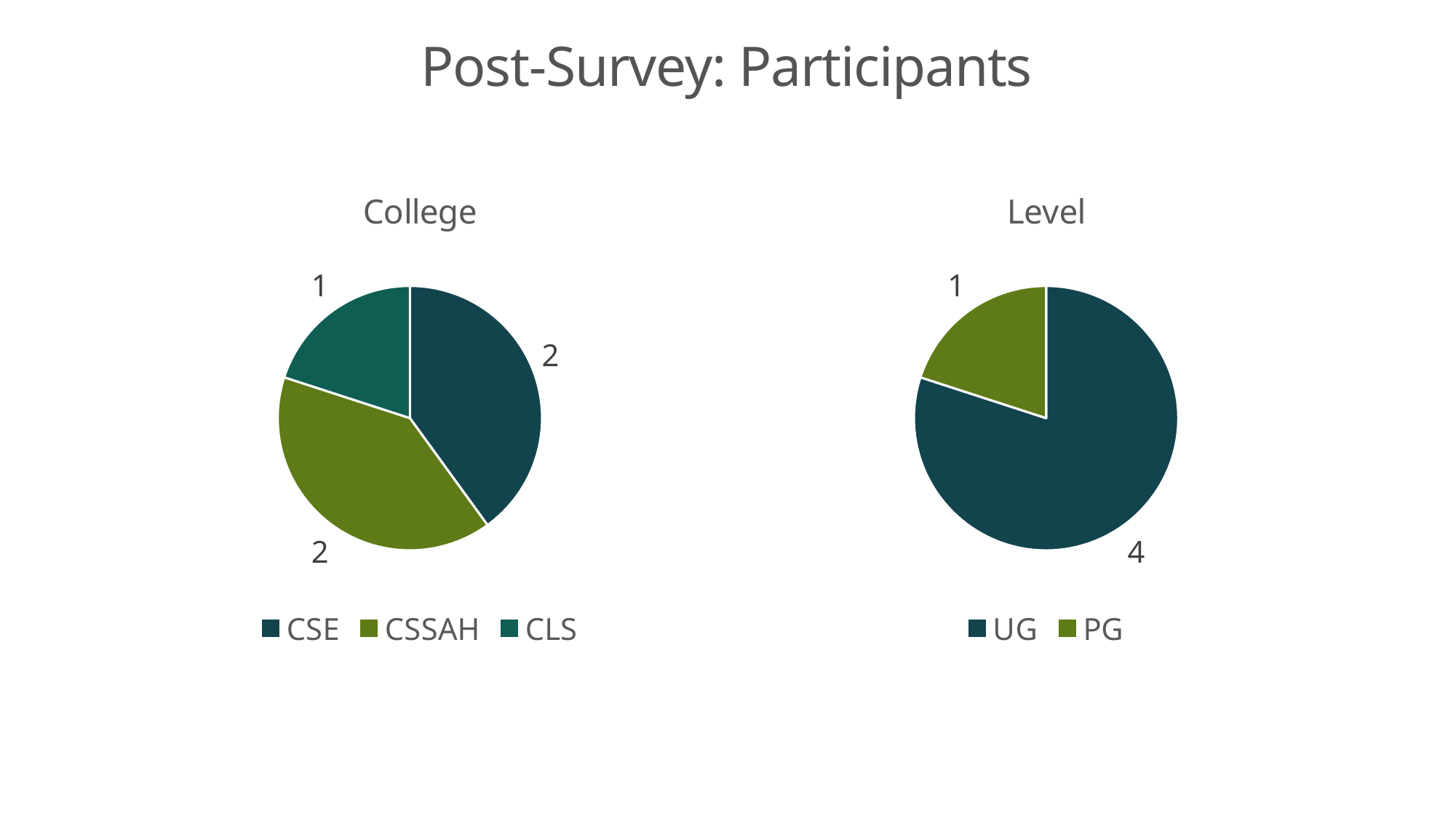
In the College chart, which category has the smallest slice? CLS In the College chart, which is larger, the value for CSSAH or the value for CLS? CSSAH How many categories does the College chart show? 3 In the Level chart, what is the difference between the UG and PG values? 3 In the Level chart, what share of the total does the UG slice represent? 80% In the Level chart, what is the value for UG? 4 In the Level chart, what is the value for PG? 1 What kind of chart is the Level chart? Pie chart In the Level chart, which category has the largest slice? UG In the College chart, what is the value for CSE? 2 In the College chart, what is the value for CLS? 1 How many entries does the legend of the Level chart list? 2